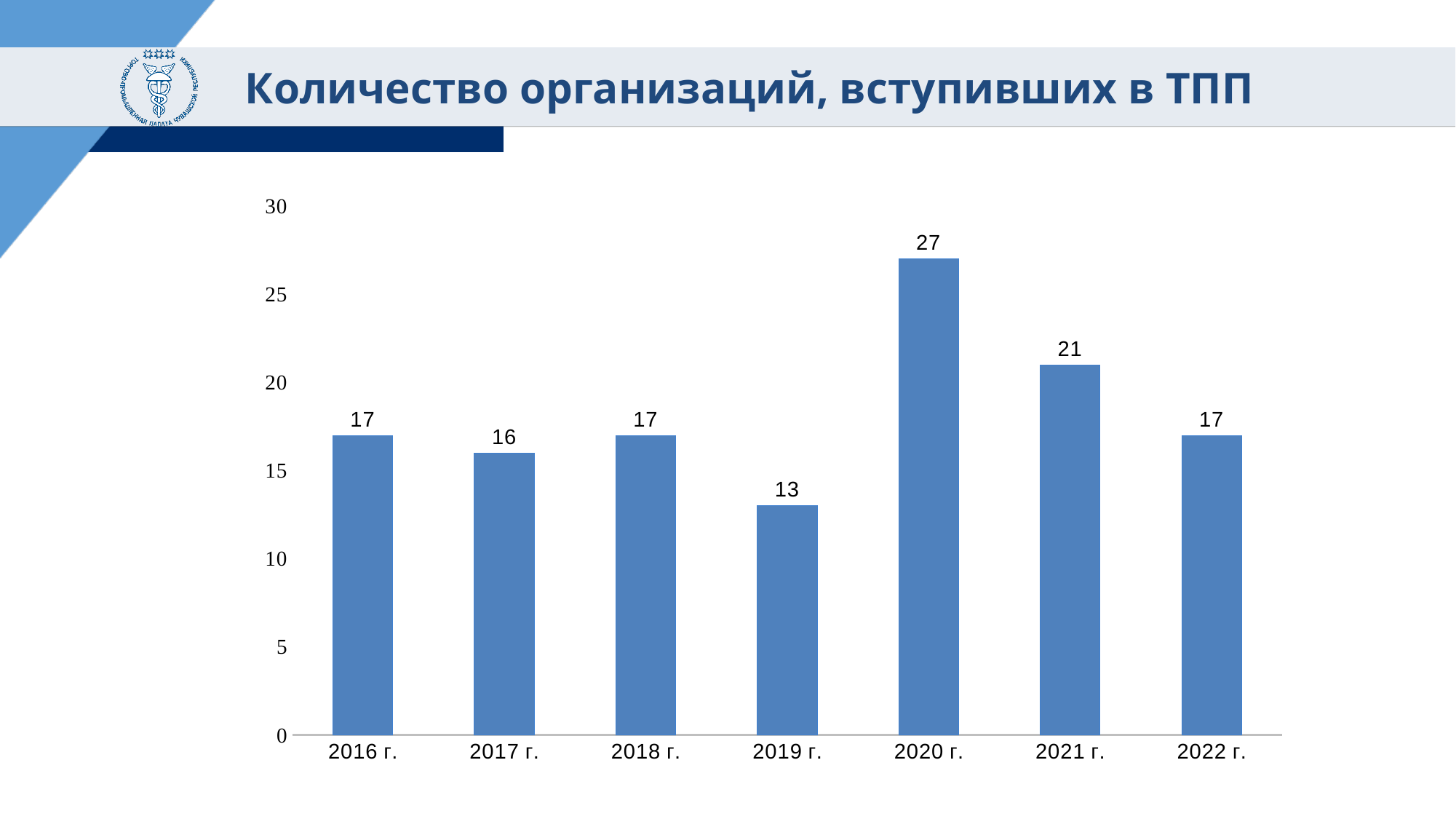
What is the value for 2020 г.? 27 Which is larger, the value for 2017 г. or the value for 2018 г.? 2018 г. What is the value for 2019 г.? 13 Which year has the highest value? 2020 г. What is the value for 2017 г.? 16 What is the difference between the values for 2021 г. and 2022 г.? 4 How many years are shown on the x axis? 7 Which year has the lowest value? 2019 г. What kind of chart is shown on the slide? bar chart What is the value for 2021 г.? 21 What is the title of the slide? Количество организаций, вступивших в ТПП What is the difference between the values for 2020 г. and 2019 г.? 14